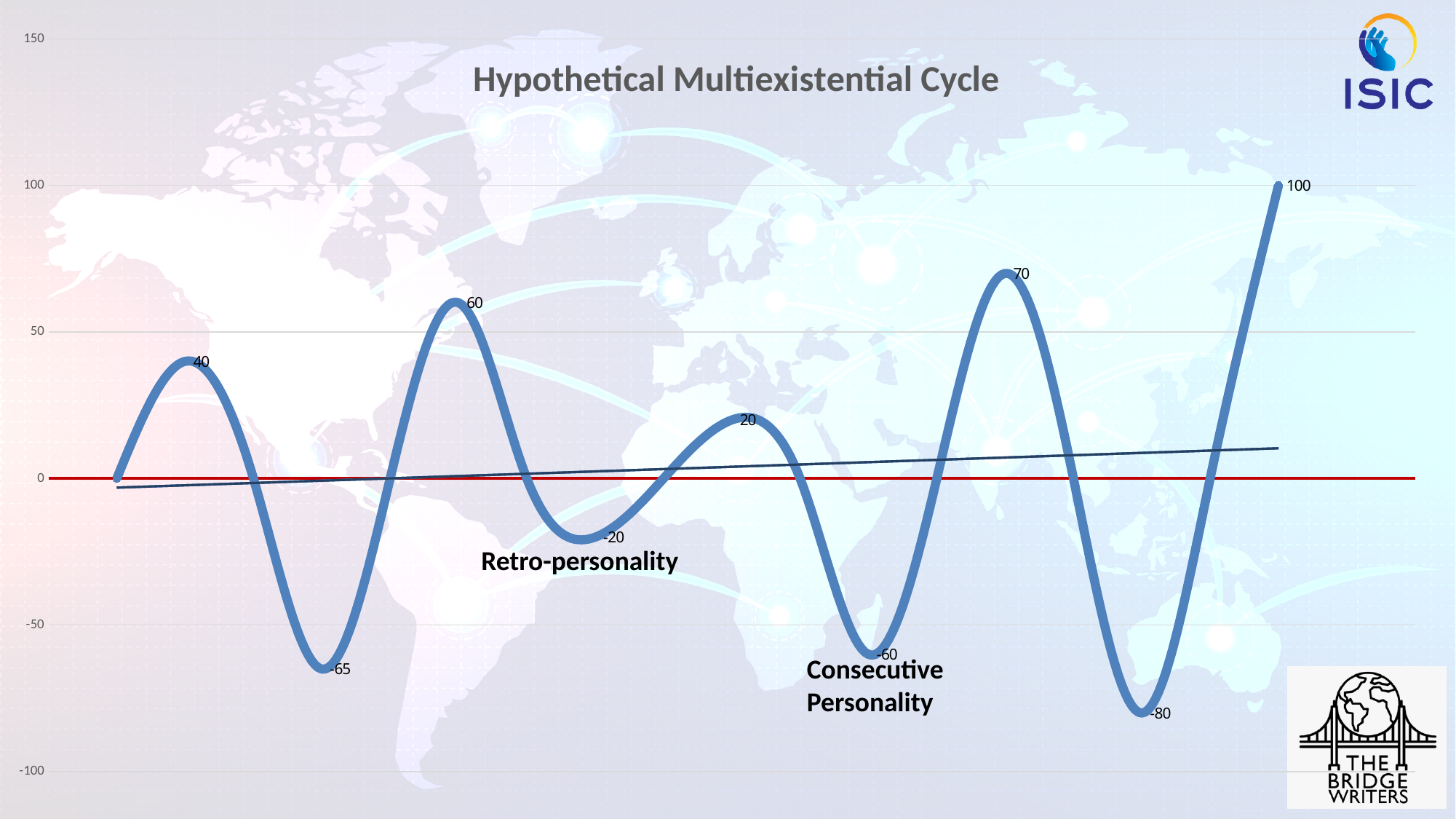
What is the difference between the final labeled value (100) and the peak labeled 70? 30 How many data labels are printed on the curve? 9 Which is larger, the peak labeled 60 or the peak labeled 20? 60 What is the value labeled at the first trough of the curve? -65 What is the value labeled at the first peak of the curve? 40 Does the thin straight trend line rise or fall from left to right? rises What kind of chart is shown on the slide? line chart What is the highest labeled value on the curve? 100 What is the lowest labeled value on the curve? -80 What value is labeled at the trough annotated 'Retro-personality'? -20 What value is labeled at the trough annotated 'Consecutive Personality'? -60 What is the title of the chart? Hypothetical Multiexistential Cycle